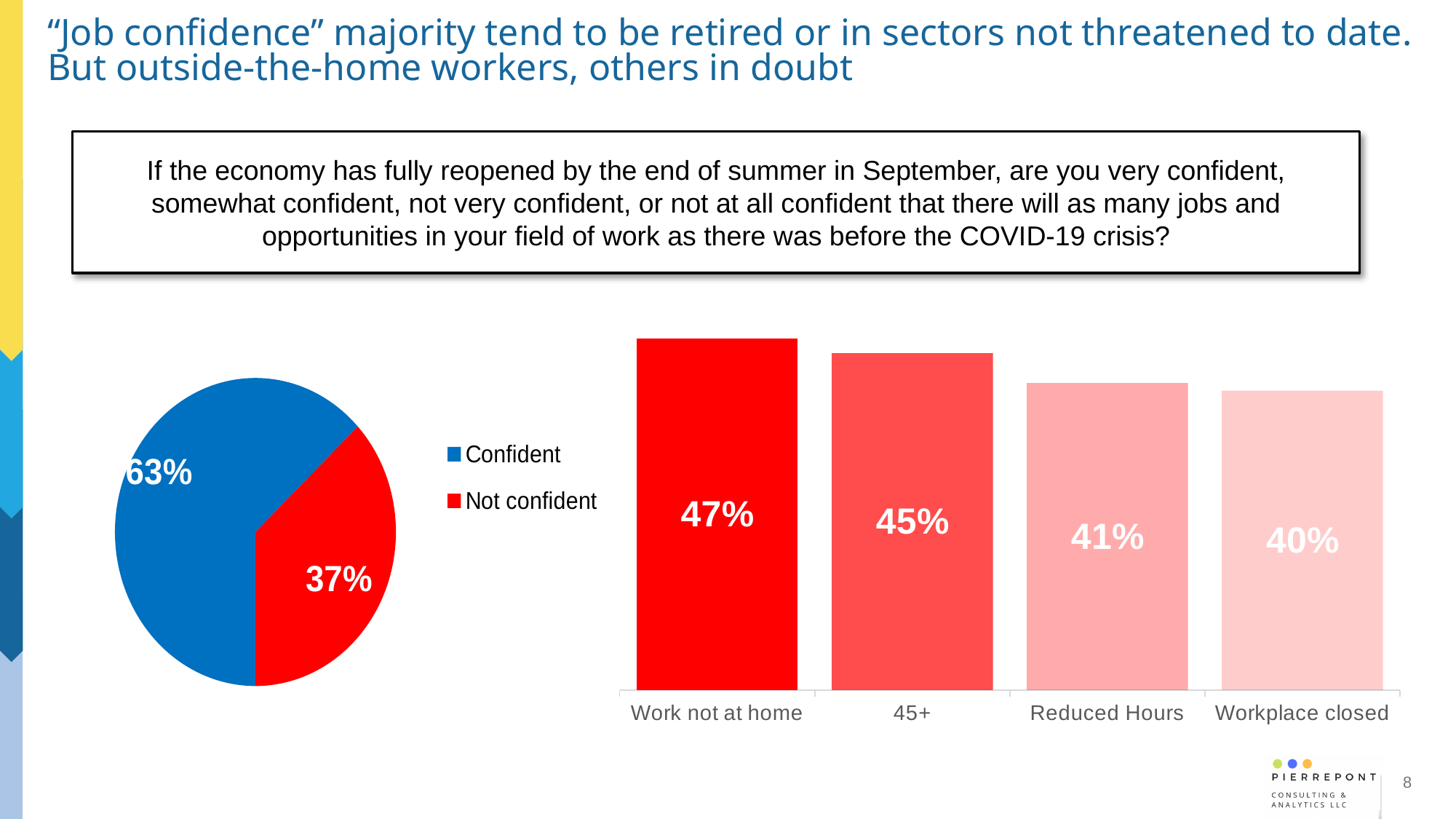
In the bar chart on the right, which category has the lowest value? Workplace closed In the pie chart on the left, which slice is larger, Confident or Not confident? Confident In the pie chart on the left, how many entries does the legend list? 2 In the pie chart on the left, what share is labelled Not confident? 37% In the bar chart on the right, what is the value for Work not at home? 47% In the pie chart on the left, what is the difference between the Confident and Not confident shares? 26% In the bar chart on the right, do the values rise or fall from left to right? fall In the bar chart on the right, how many categories are shown? 4 In the bar chart on the right, what is the difference between the values for Work not at home and Workplace closed? 7% In the bar chart on the right, what is the value for Reduced Hours? 41% In the pie chart on the left, what share is labelled Confident? 63% In the bar chart on the right, which category has the highest value? Work not at home